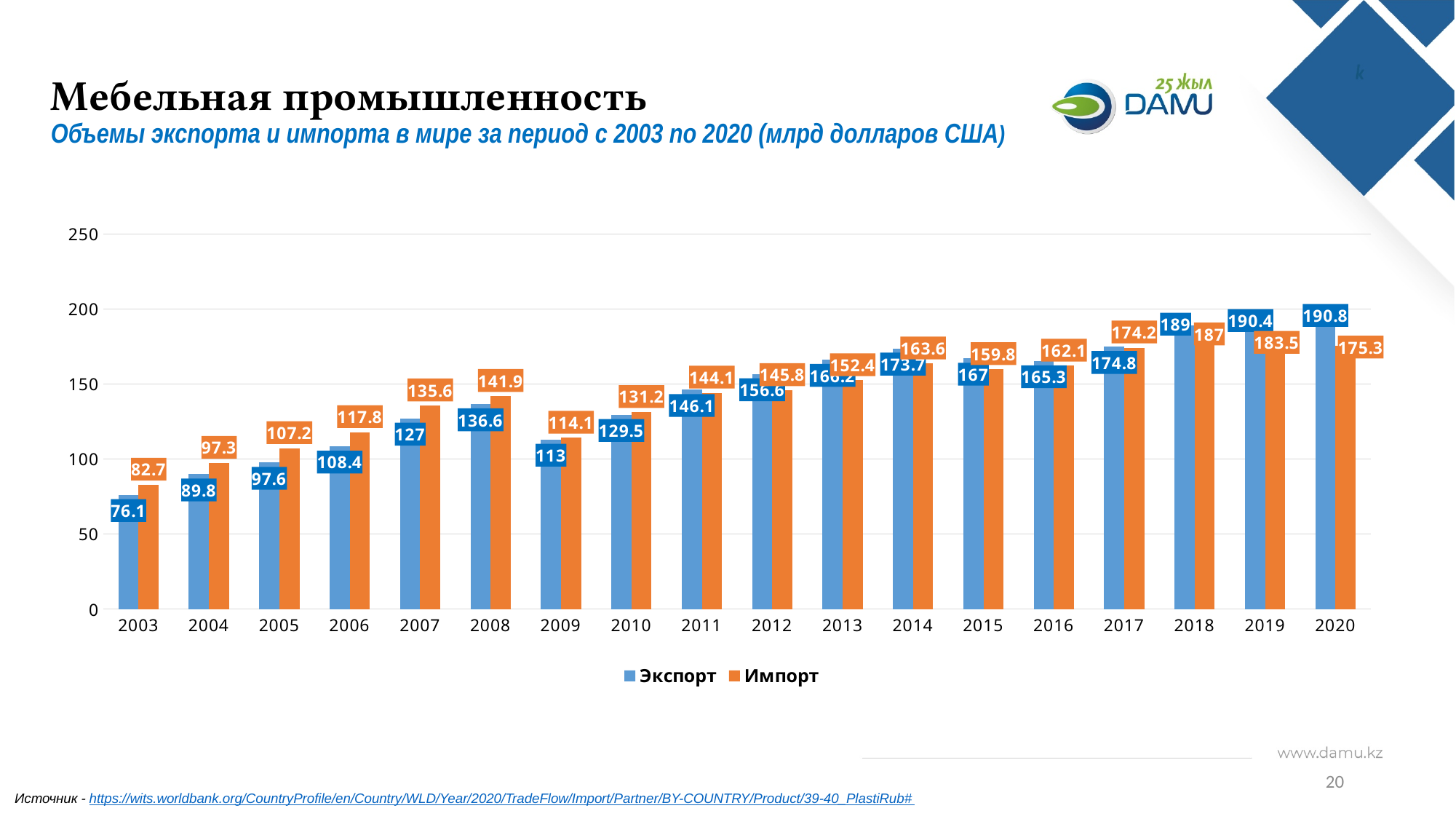
How many years are shown on the x axis? 18 What is the import value (Импорт) for 2014? 163.6 What is the export value (Экспорт) for 2003? 76.1 Which colour represents Импорт in the chart? Orange What kind of chart is shown on the slide? Bar chart How many series does the legend list? 2 What is the export value (Экспорт) for 2018? 189 In which year is the export value (Экспорт) the lowest? 2003 In which year is the import value (Импорт) the highest? 2018 Is the import value for 2012 greater or less than 150? less What is the difference between the import and export values in 2020? 15.5 Which is larger in 2008, the export value or the import value? Import (Импорт)